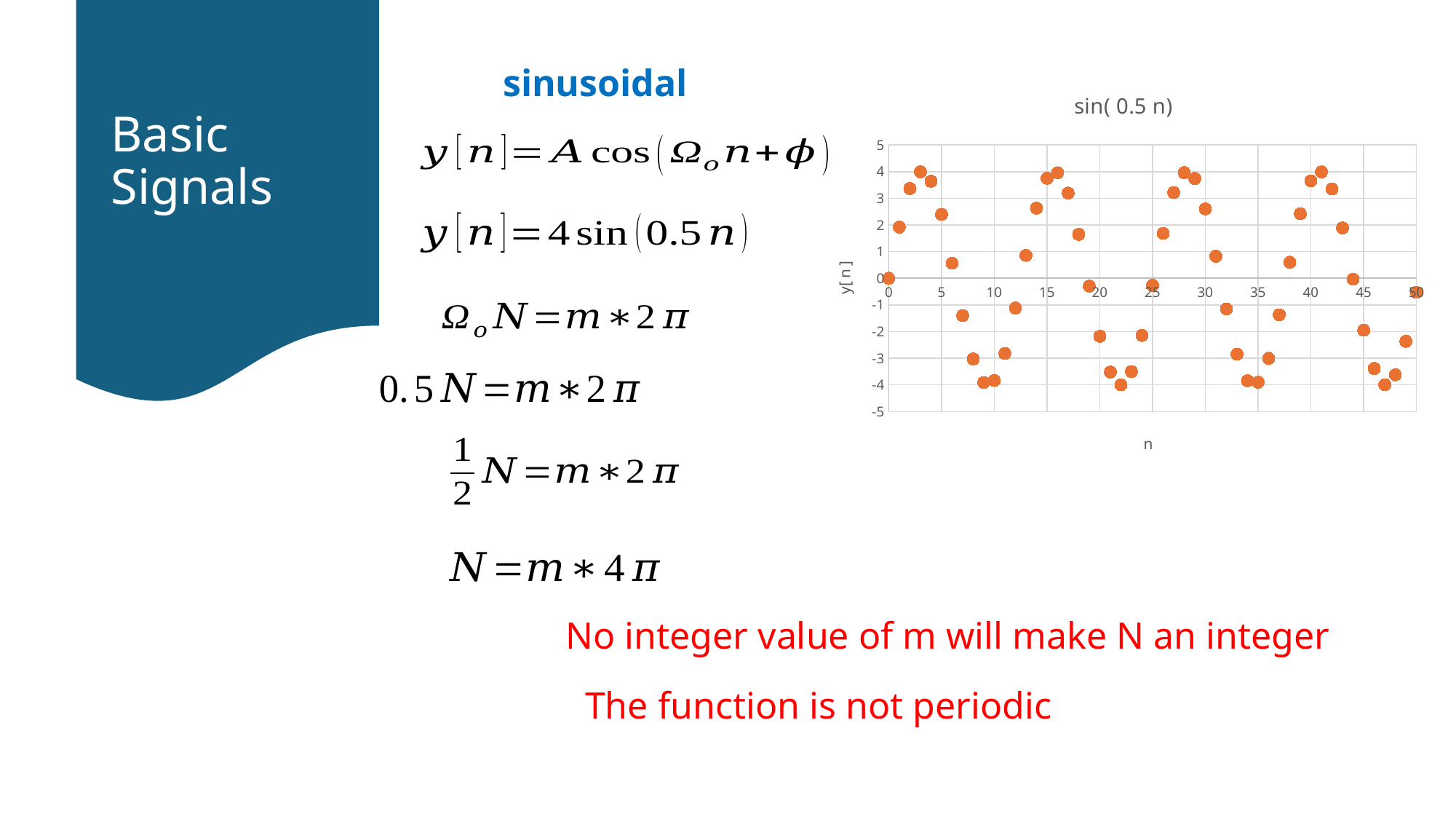
What is the title of the chart? sin( 0.5 n) What kind of chart is shown on the slide? scatter chart What is the label of the vertical axis of the chart? y[n] Is the value plotted at n = 16 greater or less than 3? greater Is the value plotted at n = 3 greater or less than 3? greater Do the plotted values rise steadily, fall steadily, or oscillate as n increases? oscillate What is the value of y[n] at n = 0 in the chart? 0 Is the value plotted at n = 41 greater or less than 3? greater Is the value plotted at n = 3 larger or smaller than the value plotted at n = 9? larger